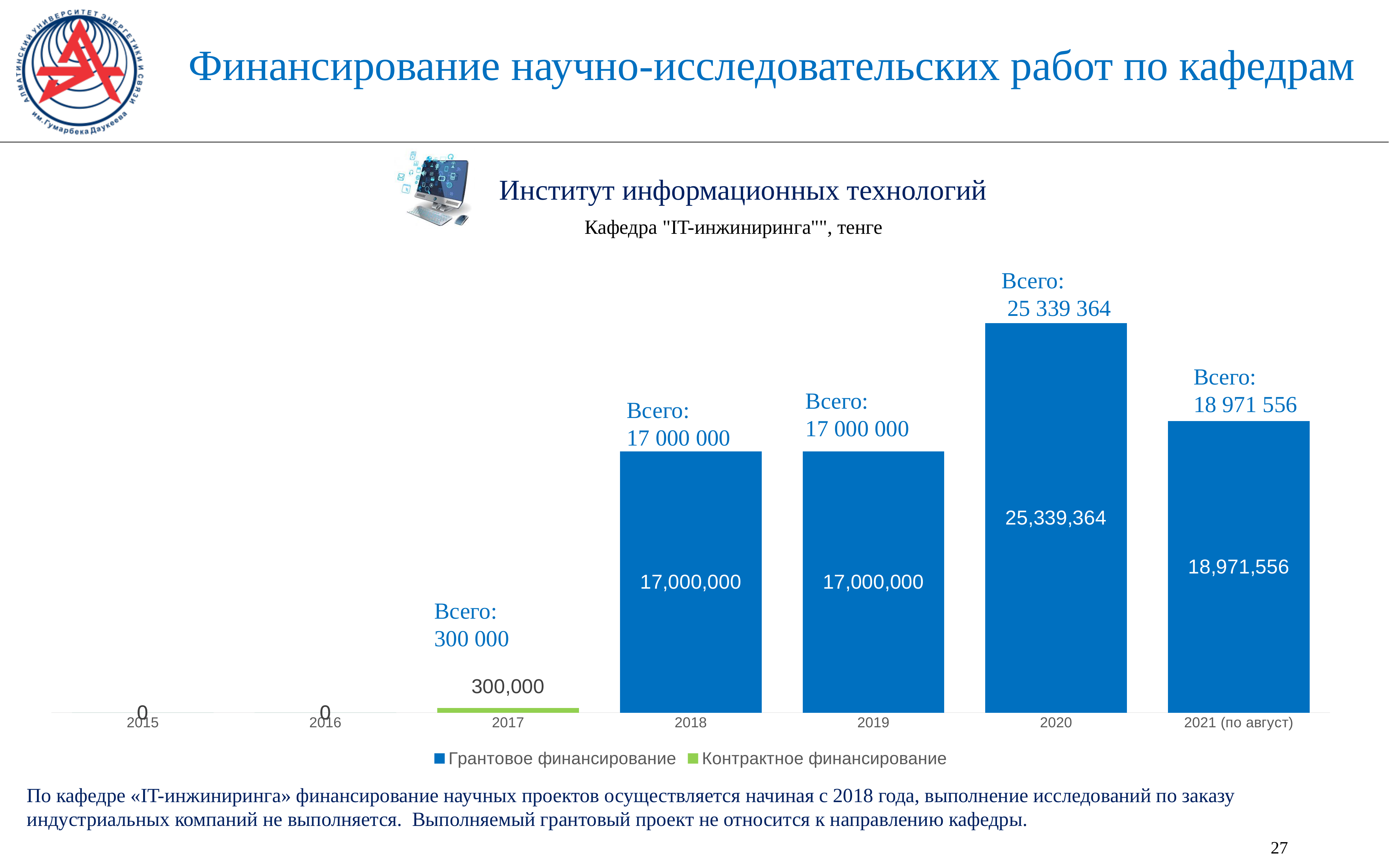
What is the value shown for 2017? 300,000 What is the difference between the 2020 value and the 2021 (по август) value? 6,367,808 What is the value of grant funding for 2018? 17,000,000 Which is larger, the value for 2019 or the value for 2021 (по август)? 2021 (по август) Which series does the 2017 bar belong to? Контрактное финансирование Which year has the highest funding value? 2020 How many series does the legend list? 2 What type of chart is shown on the slide? bar chart What is the value of grant funding (Грантовое финансирование) for 2020? 25,339,364 What value is shown for 2015 and 2016? 0 What is the value of grant funding (Грантовое финансирование) for 2021 (по август)? 18,971,556 How many years (categories) are shown on the x axis? 7